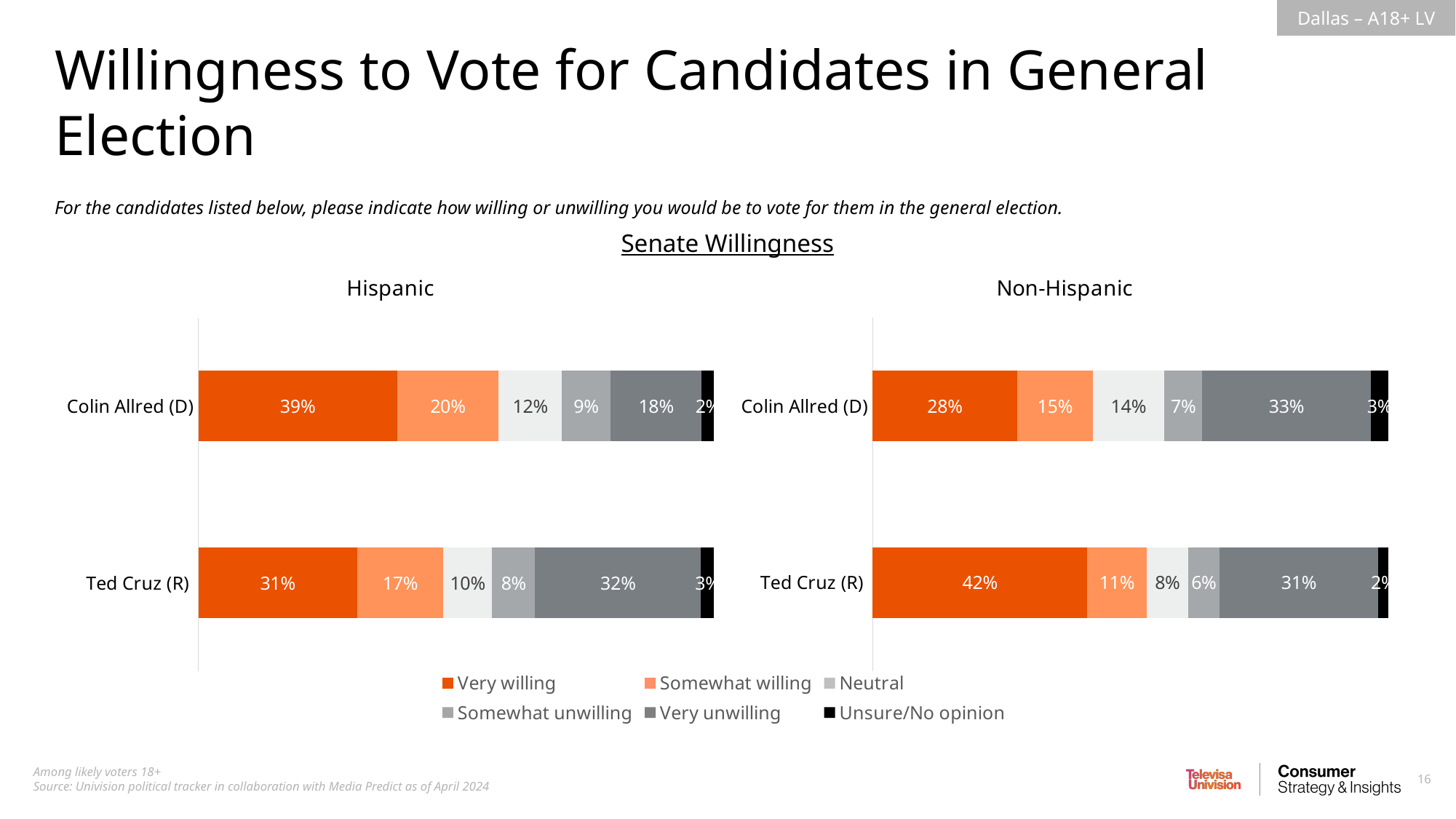
In the Hispanic chart, what percentage of respondents are somewhat willing to vote for Ted Cruz (R)? 17% In the Non-Hispanic chart, which candidate has the higher very willing percentage? Ted Cruz (R) In the Hispanic chart, which candidate has the higher very willing percentage? Colin Allred (D) How many series does the legend list? 6 What type of chart is used to show Senate Willingness? Stacked bar chart In the Hispanic chart, what is the difference between the very unwilling percentages for Ted Cruz (R) and Colin Allred (D)? 14% In the Non-Hispanic chart, what is the difference between the very willing percentages for Ted Cruz (R) and Colin Allred (D)? 14% In the Non-Hispanic chart, what percentage of respondents are very unwilling to vote for Colin Allred (D)? 33% In the Non-Hispanic chart, what percentage of respondents are very willing to vote for Ted Cruz (R)? 42% How many candidates are shown in the Hispanic chart? 2 In the Hispanic chart, what is the combined very willing and somewhat willing percentage for Colin Allred (D)? 59% In the Hispanic chart, what percentage of respondents are very willing to vote for Colin Allred (D)? 39%